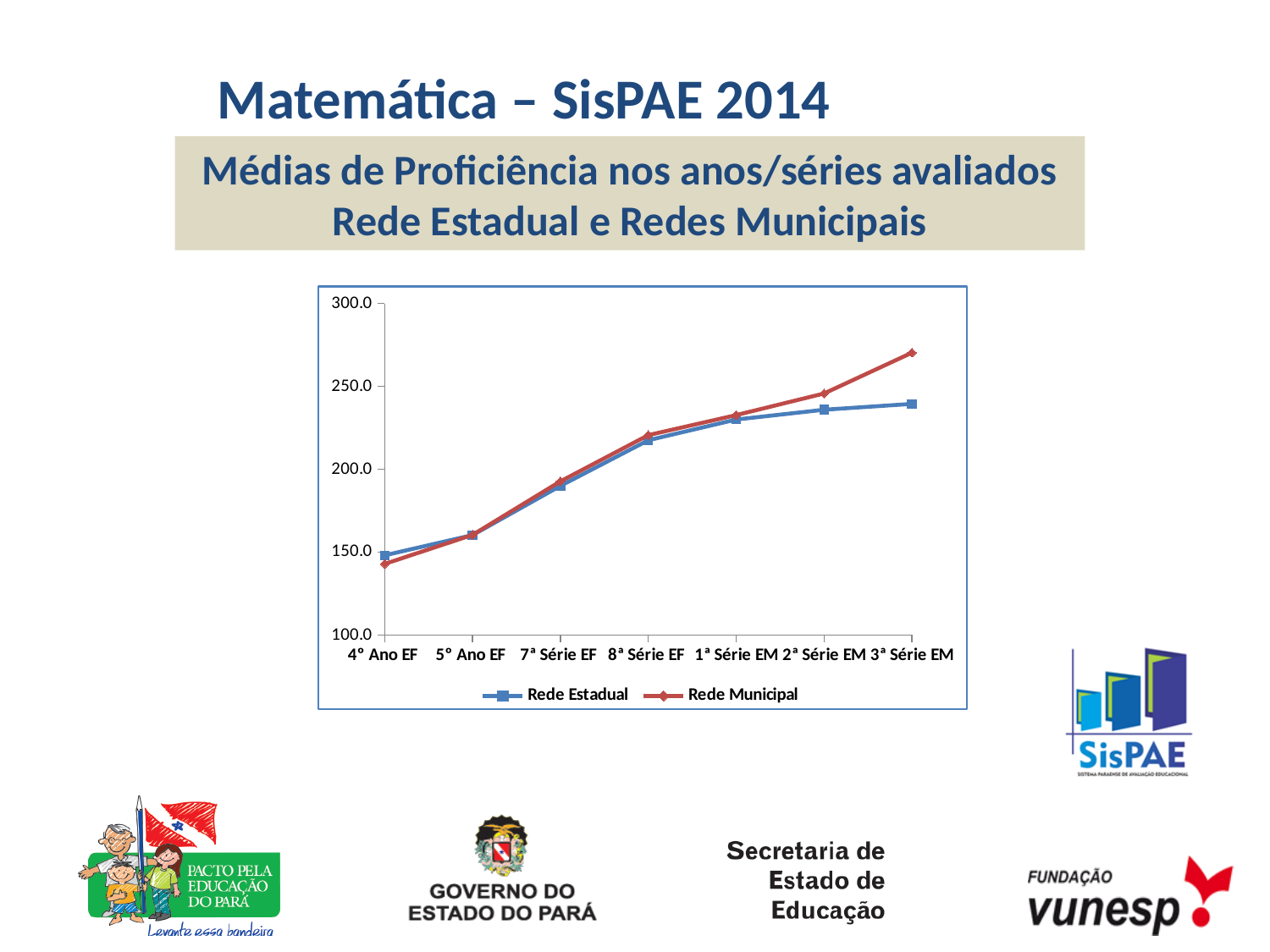
Is the value for Rede Municipal at 8ª Série EF greater or less than 200? greater What kind of chart is shown on the slide? line chart Is the value for Rede Estadual at 3ª Série EM greater or less than 250? less Is the value for Rede Municipal at 3ª Série EM greater or less than 250? greater Do the values for Rede Municipal rise or fall from 4° Ano EF to 3ª Série EM? rise How many categories are shown on the x axis? 7 For which category is the Rede Municipal value highest? 3ª Série EM At 3ª Série EM, which series has the larger value, Rede Estadual or Rede Municipal? Rede Municipal For which category is the Rede Estadual value lowest? 4° Ano EF Do the values for Rede Estadual rise or fall along the x axis? rise How many series does the legend list? 2